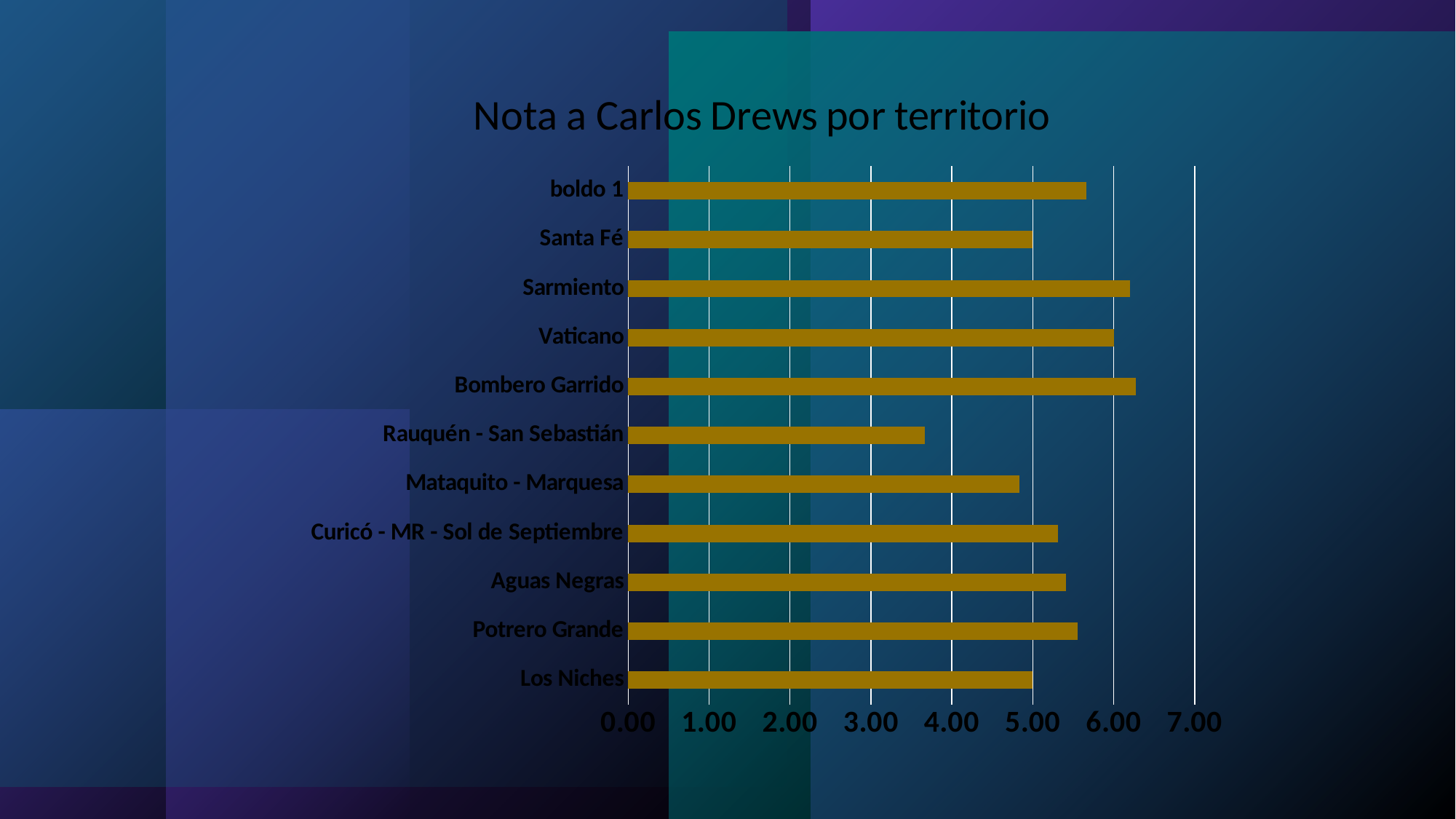
Which is larger, the value for Mataquito - Marquesa or the value for Rauquén - San Sebastián? Mataquito - Marquesa Is the value for Bombero Garrido greater or less than 6.00? greater What is the title of the chart? Nota a Carlos Drews por territorio Which is larger, the value for Sarmiento or the value for Santa Fé? Sarmiento What kind of chart is shown on the slide? bar chart Is the value for boldo 1 greater or less than 5.00? greater Is the value for Rauquén - San Sebastián greater or less than 4.00? less Which is larger, the value for Vaticano or the value for Los Niches? Vaticano Which territory has the lowest value? Rauquén - San Sebastián How many territories are plotted in the chart? 11